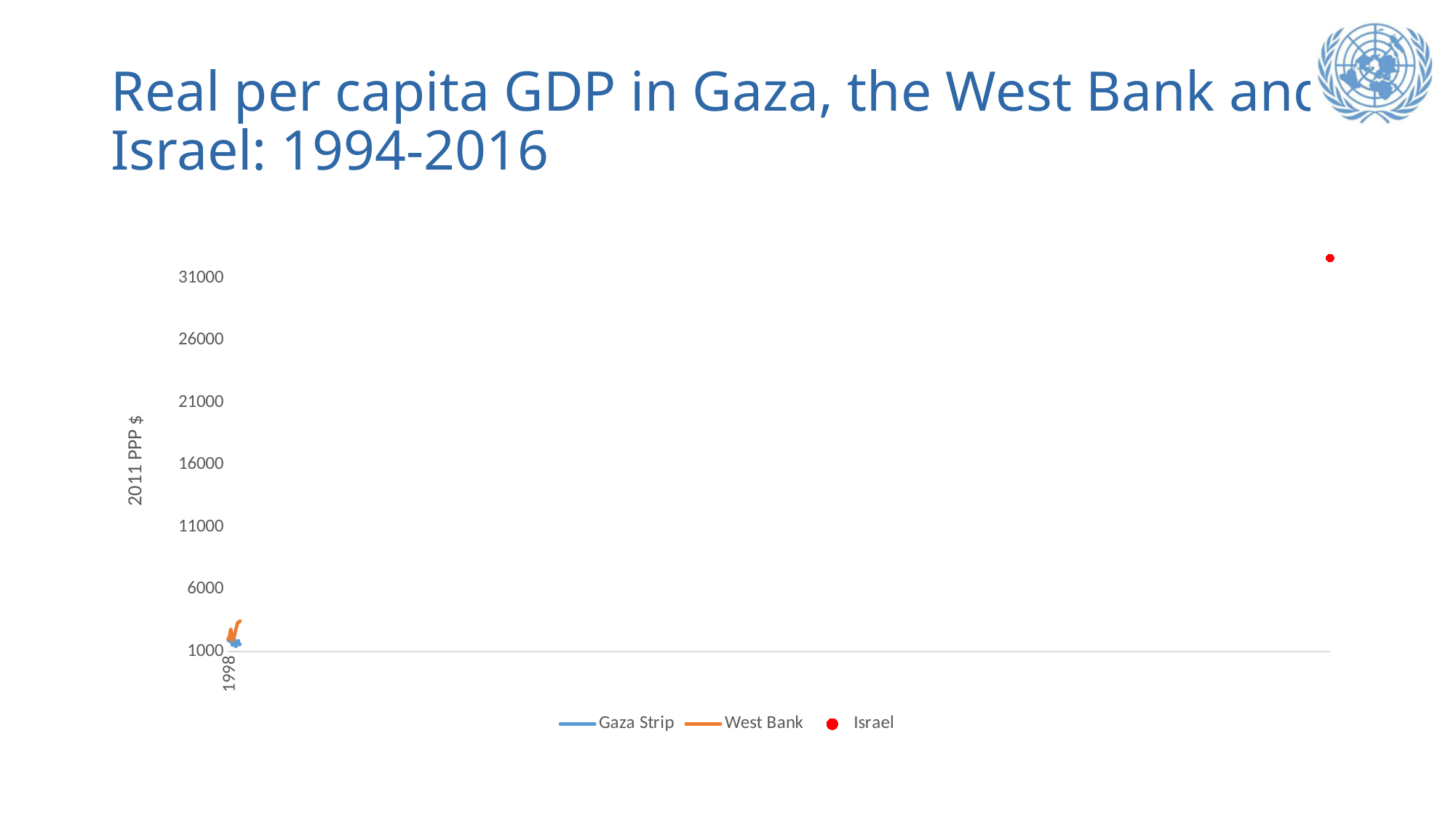
Are the plotted values for the Gaza Strip greater or less than 6000? less Which series reaches the highest value on the chart? Israel What is the label on the vertical axis? 2011 PPP $ Which is larger, the plotted value for Israel or the plotted values for the Gaza Strip? Israel What is the highest tick value shown on the vertical axis? 31000 How many series does the legend list? 3 Are the plotted values for the West Bank greater or less than 6000? less Which is larger, the plotted value for Israel or the plotted values for the West Bank? Israel Which series are listed in the legend? Gaza Strip, West Bank, Israel Is the plotted value for Israel greater or less than 26000? greater